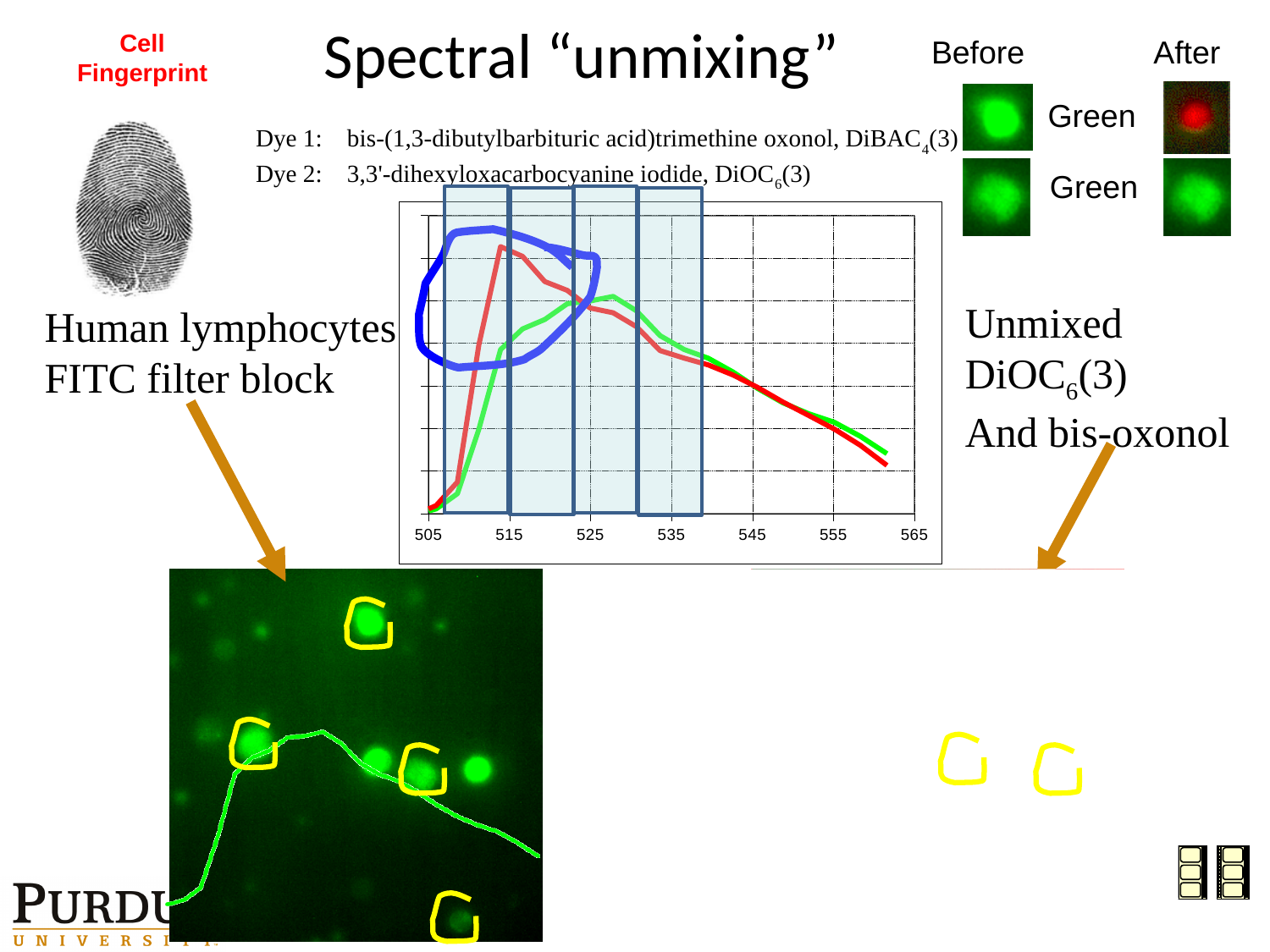
What kind of chart is shown in the centre of the slide? line chart Which line reaches its peak at the shorter wavelength, the red line or the green line? red How many tick labels are shown on the x axis of the spectral chart? 7 What colours are the two lines plotted on the spectral chart? red and green At x = 515, which line is higher, the red line or the green line? red What is the lowest value labelled on the x axis of the spectral chart? 505 At x = 530, which line is higher, the red line or the green line? green How many shaded vertical bands are overlaid on the spectral chart? 4 What is the spacing between consecutive x-axis tick labels on the spectral chart? 10 How many lines are plotted on the spectral chart? 2 What is the highest value labelled on the x axis of the spectral chart? 565 Do the plotted lines rise or fall between x = 535 and x = 565? fall